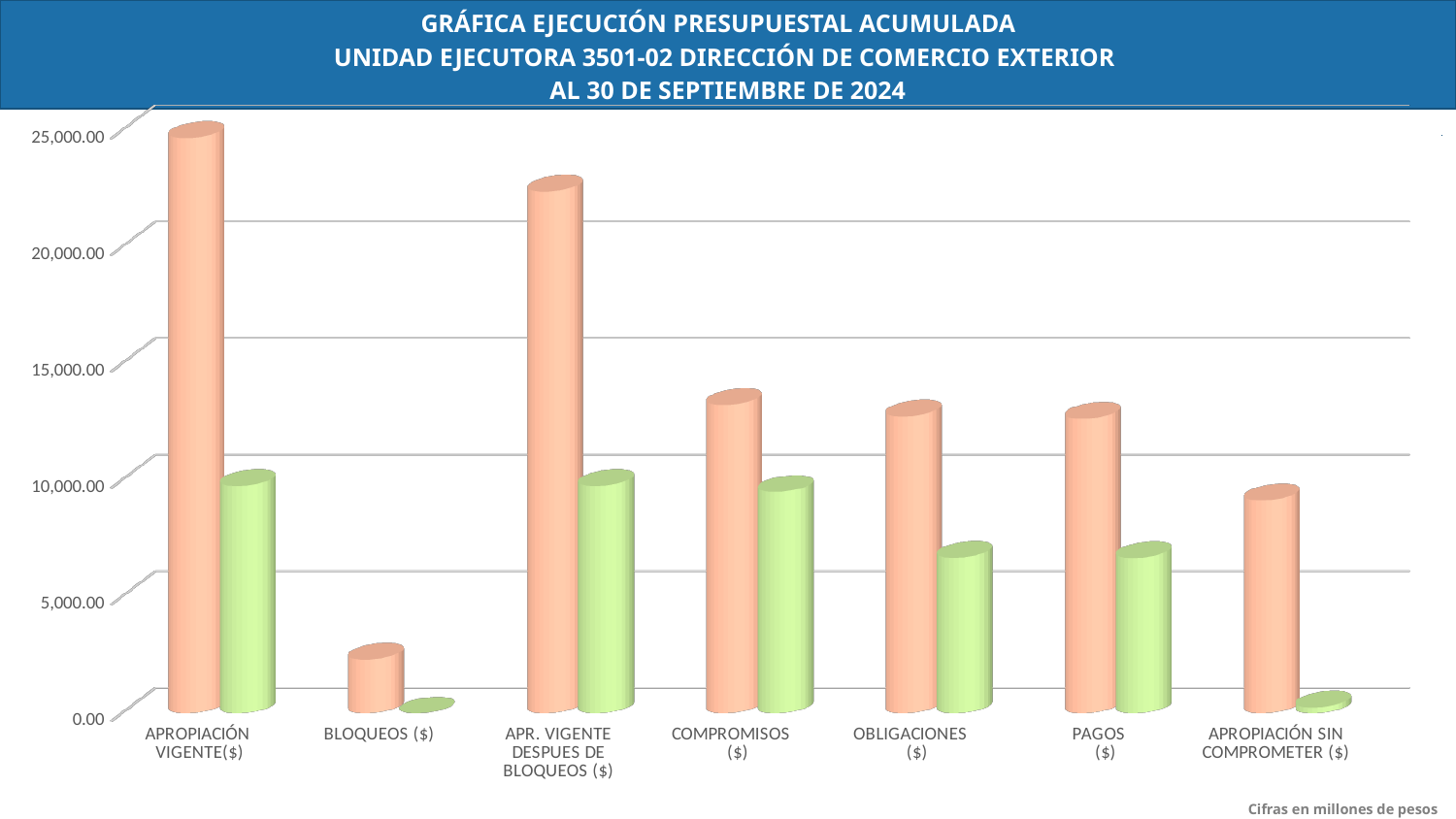
Is the orange bar for APROPIACIÓN VIGENTE($) greater or less than 20,000.00? greater Which category has the tallest orange bar? APROPIACIÓN VIGENTE($) How many categories are shown along the x axis of the chart? 7 Is the orange bar for BLOQUEOS ($) greater or less than 5,000.00? less Is the orange bar for COMPROMISOS ($) greater or less than 10,000.00? greater What date does the chart title say the cumulative budget execution is reported as of? 30 de septiembre de 2024 Which has the taller orange bar: PAGOS ($) or APROPIACIÓN SIN COMPROMETER ($)? PAGOS ($) What kind of chart is shown on the slide? Bar chart Which category has the shortest orange bar? BLOQUEOS ($) According to the note at the bottom right of the slide, in what units are the figures expressed? Millones de pesos Which has the taller orange bar: APR. VIGENTE DESPUES DE BLOQUEOS ($) or COMPROMISOS ($)? APR. VIGENTE DESPUES DE BLOQUEOS ($)